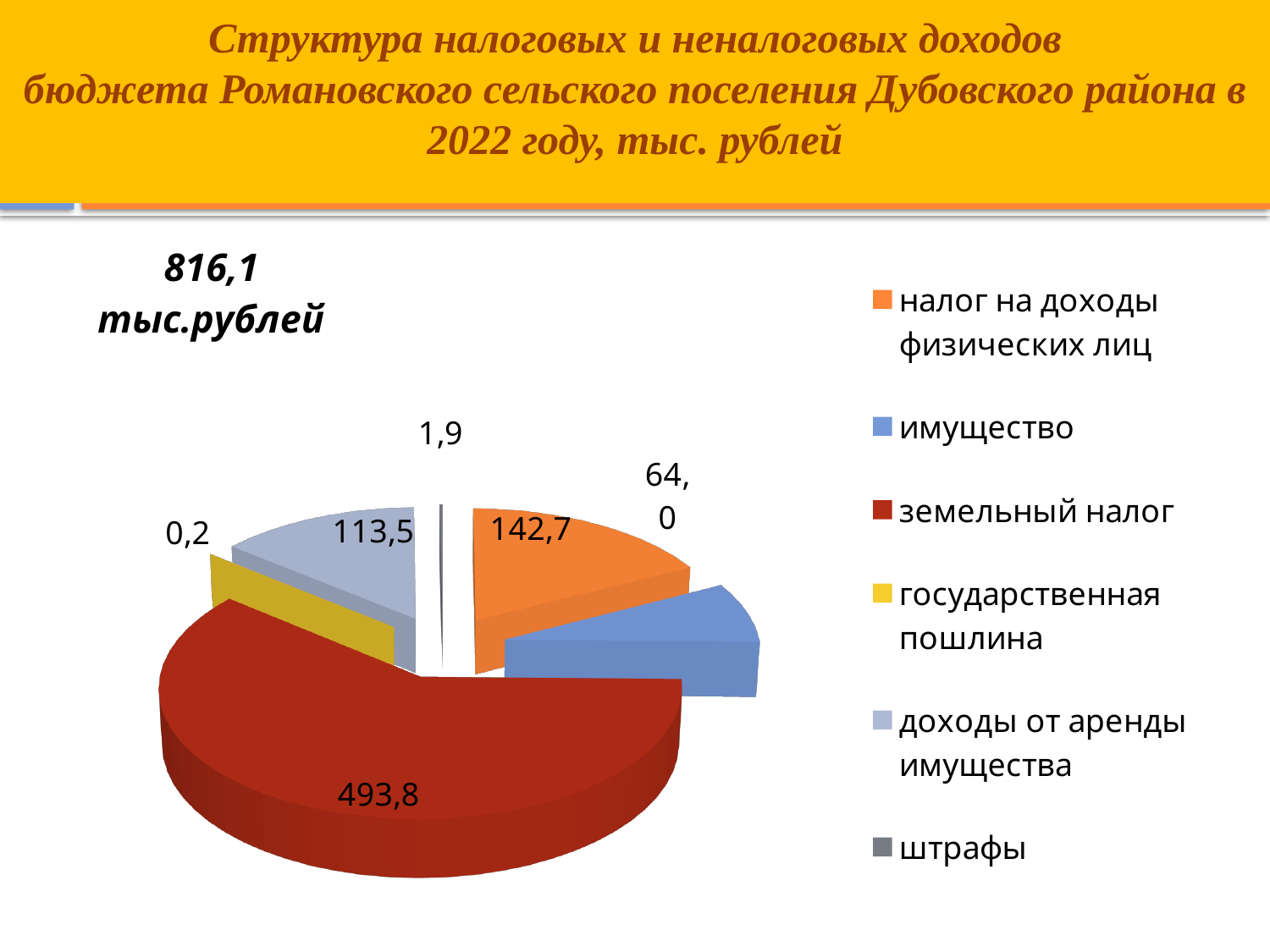
Which is larger: the value for налог на доходы физических лиц or the value for доходы от аренды имущества? налог на доходы физических лиц Which category has the largest slice of the pie? земельный налог How many categories does the legend list? 6 What is the value for доходы от аренды имущества? 113,5 What is the value for имущество? 64,0 Which category has the smallest slice of the pie? государственная пошлина What total amount in тыс. рублей is stated on the slide for the pie chart? 816,1 What is the value for земельный налог? 493,8 What is the value for налог на доходы физических лиц? 142,7 What is the difference between the values for земельный налог and налог на доходы физических лиц? 351,1 What is the value for государственная пошлина? 0,2 What type of chart is shown on the slide? pie chart